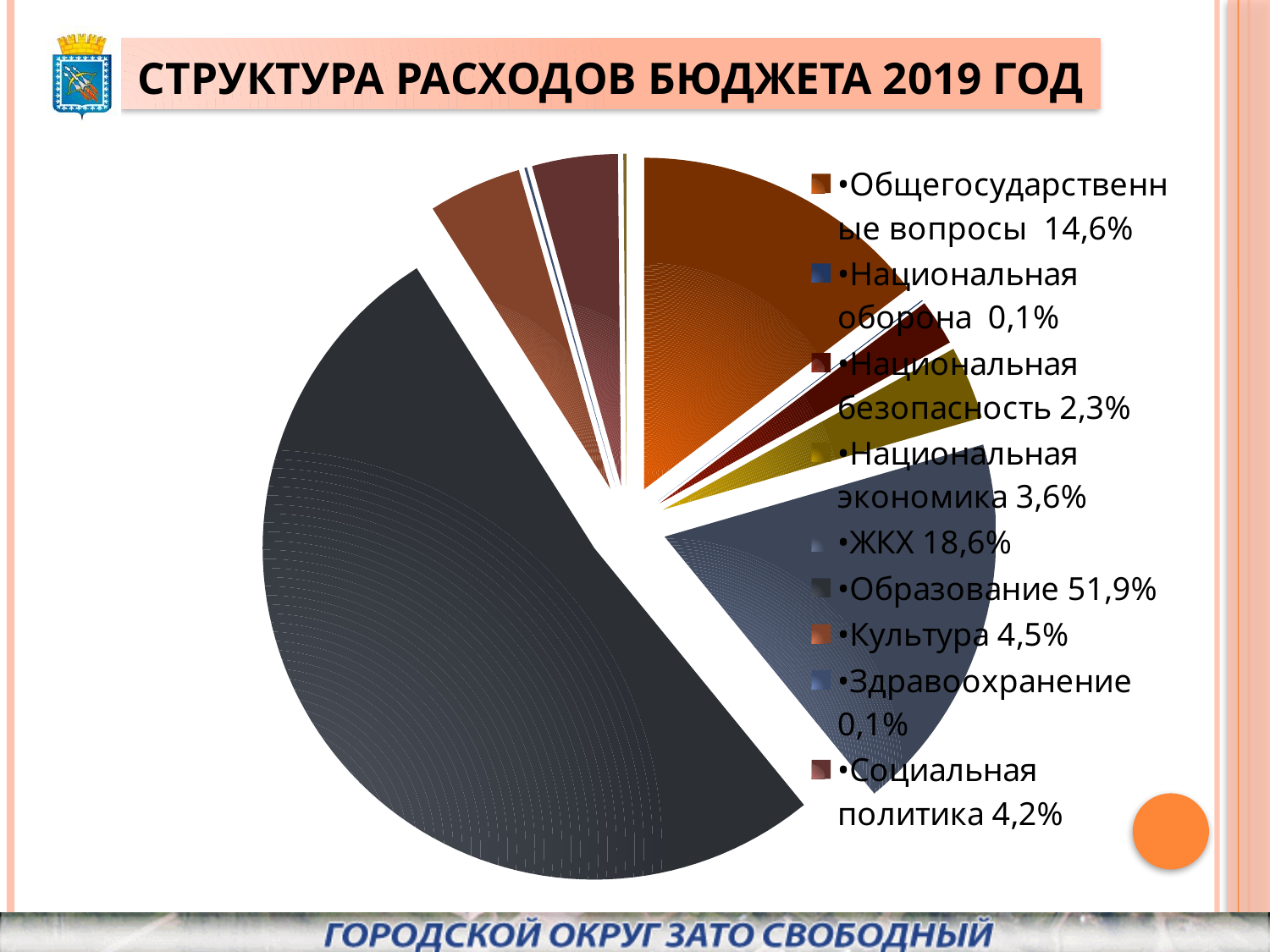
Which is larger, the share for Культура or the share for Социальная политика? Культура Which category has the largest share of the budget expenditure? Образование How many categories does the pie chart have? 10 What share of the budget expenditure goes to Образование? 51,9% What share of the budget expenditure goes to ЖКХ? 18,6% What is the title of the chart on the slide? СТРУКТУРА РАСХОДОВ БЮДЖЕТА 2019 ГОД What share of the budget expenditure goes to Общегосударственные вопросы? 14,6% What is the difference between the share for ЖКХ and the share for Общегосударственные вопросы? 4,0% What is the difference between the share for Образование and the share for ЖКХ? 33,3% What share of the budget expenditure goes to Национальная экономика? 3,6% What share of the budget expenditure goes to Социальная политика? 4,2% What type of chart is shown on the slide? pie chart